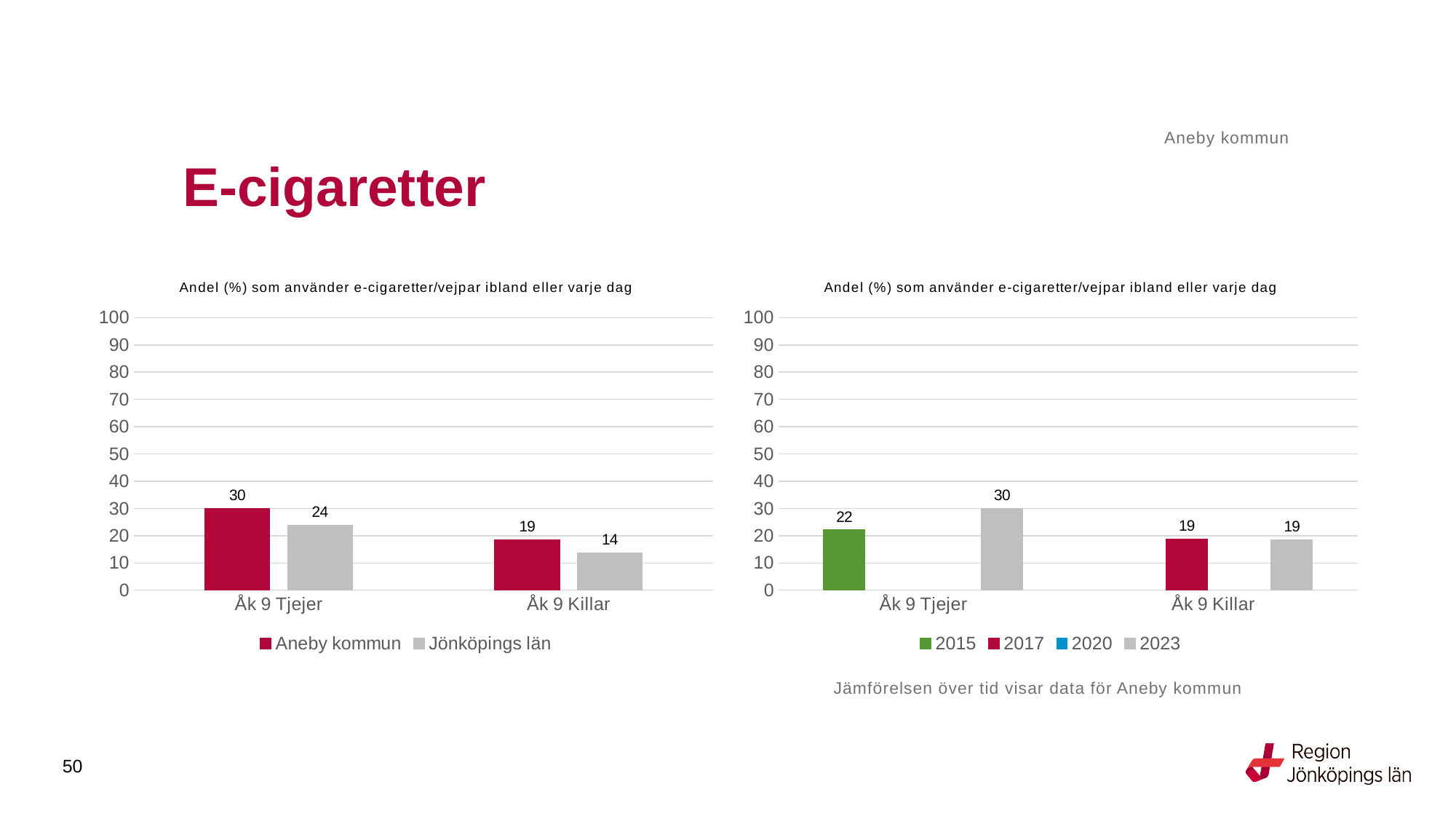
In the right chart, is the value for 2023 for Åk 9 Tjejer greater or less than 20? greater In the right chart, what is the value for 2015 for Åk 9 Tjejer? 22 In the right chart, what is the value for 2017 for Åk 9 Killar? 19 In the left chart, how many series does the legend list? 2 In the left chart, what is the value for Aneby kommun for Åk 9 Tjejer? 30 In the right chart, how many series does the legend list? 4 In the right chart, what is the value for 2023 for Åk 9 Tjejer? 30 In the left chart, what is the value for Jönköpings län for Åk 9 Killar? 14 In the left chart, which is larger for Åk 9 Killar: Aneby kommun or Jönköpings län? Aneby kommun In the right chart, what is the difference between the 2023 and 2015 values for Åk 9 Tjejer? 8 In the left chart, what is the difference between Aneby kommun and Jönköpings län for Åk 9 Tjejer? 6 What kind of chart is the left chart? Bar chart